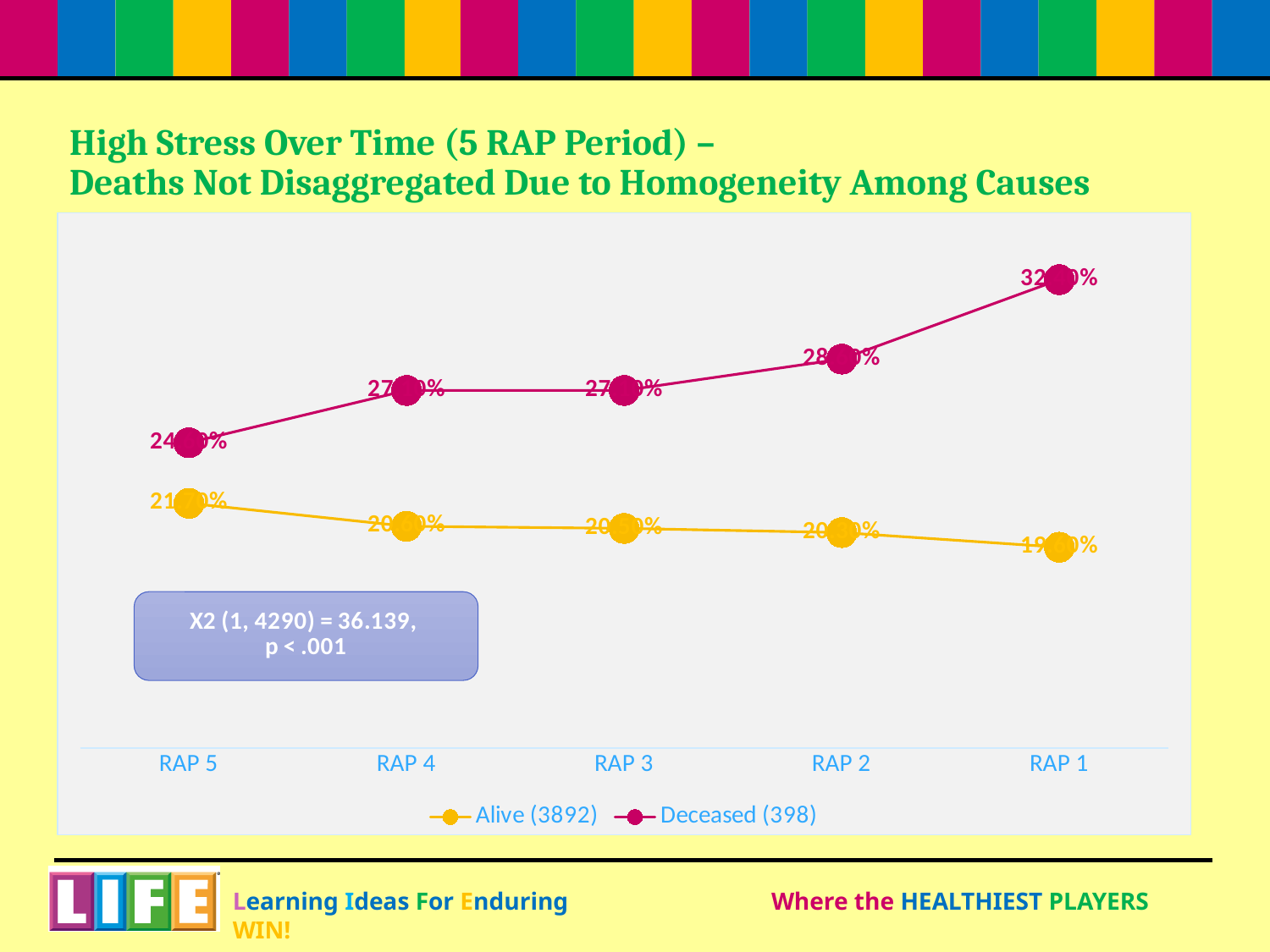
Does the Deceased series rise or fall moving from RAP 5 to RAP 1 along the x axis? rise What kind of chart is shown on the slide? line chart What are the two legend entries? Alive (3892) and Deceased (398) At which RAP period is the Deceased series lowest? RAP 5 Does the Alive series rise or fall moving from RAP 5 to RAP 1 along the x axis? fall How many RAP periods are shown on the x axis? 5 At which RAP period is the Deceased series highest? RAP 1 At which RAP period is the Alive series lowest? RAP 1 Which series is plotted in magenta? Deceased (398) How many series does the legend list? 2 At which RAP period is the Alive series highest? RAP 5 At RAP 1, which series has the larger value, Alive or Deceased? Deceased